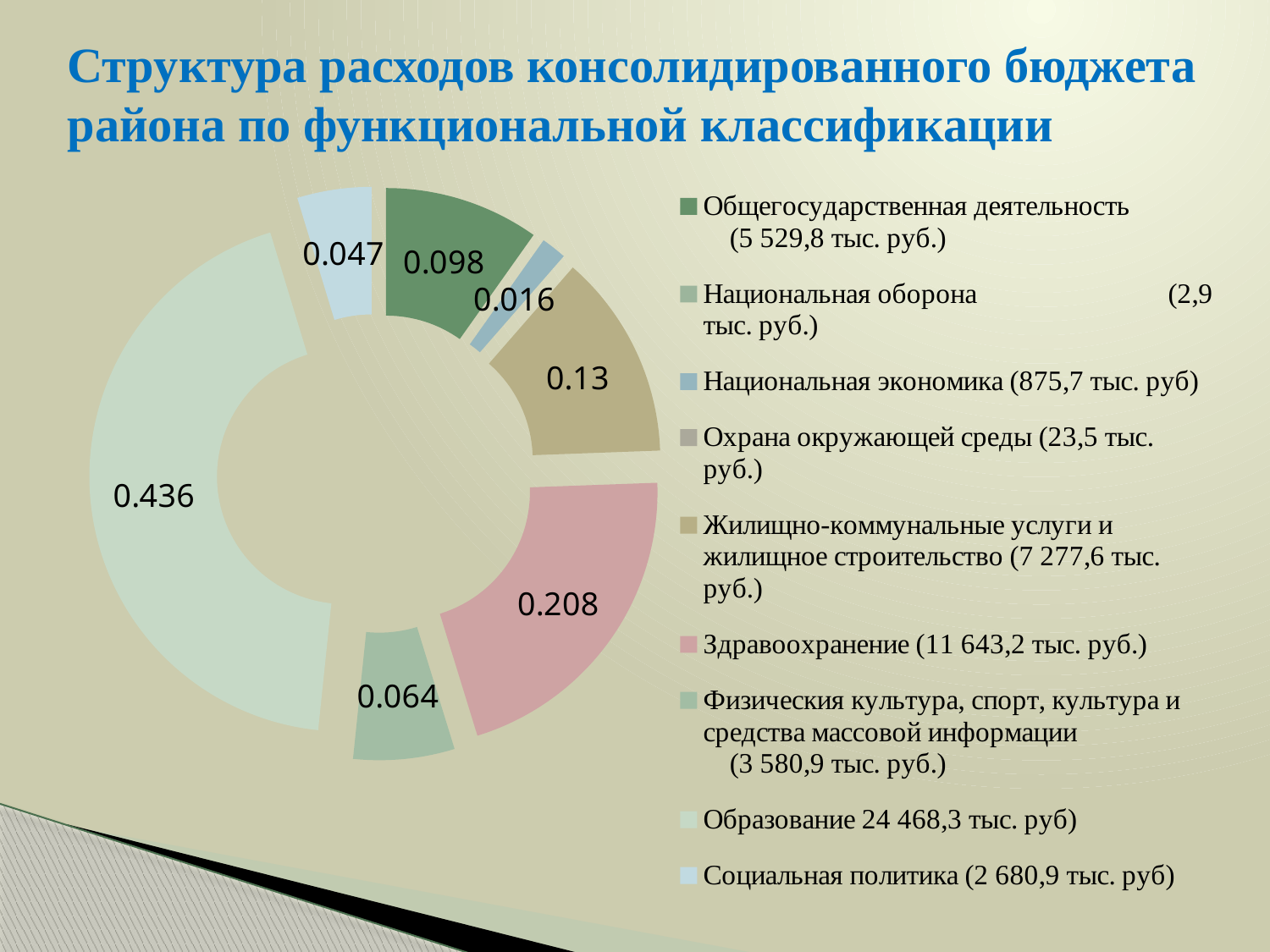
How many categories does the legend list? 9 What amount in тыс. руб. does the legend give for Образование? 24 468,3 тыс. руб What share is shown for Здравоохранение? 0.208 What share is shown for Жилищно-коммунальные услуги и жилищное строительство? 0.13 What share is shown for Общегосударственная деятельность? 0.098 What is the difference between the share for Образование and the share for Здравоохранение? 0.228 What share is shown for Физическия культура, спорт, культура и средства массовой информации? 0.064 What share is shown for Социальная политика? 0.047 What share is shown for Образование? 0.436 What kind of chart is shown on the slide? doughnut chart Which category has the largest share of the doughnut? Образование Which is larger, the share for Здравоохранение or the share for Жилищно-коммунальные услуги и жилищное строительство? Здравоохранение